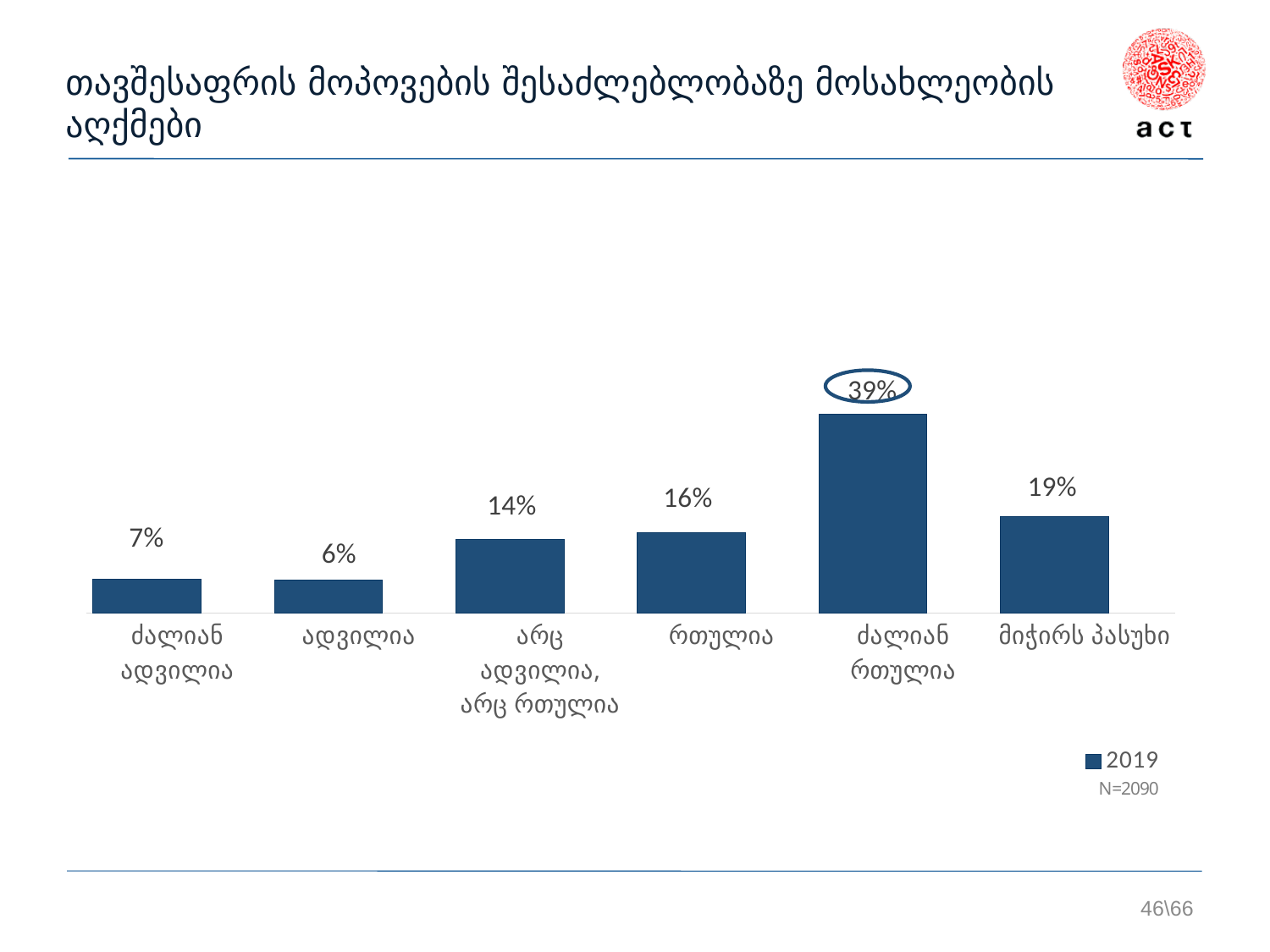
Which category has the lowest value? ადვილია How many series does the legend list? 1 Which category has the highest value? ძალიან რთულია What year does the legend entry show? 2019 What is the value for ადვილია? 6% What is the value for ძალიან რთულია? 39% How many categories are shown on the x axis? 6 What is the value for მიჭირს პასუხი? 19% Which is larger, the value for ძალიან ადვილია or the value for ადვილია? ძალიან ადვილია What kind of chart is shown on the slide? bar chart What is the difference between the values for ძალიან რთულია and რთულია? 23% What is the value for არც ადვილია, არც რთულია? 14%